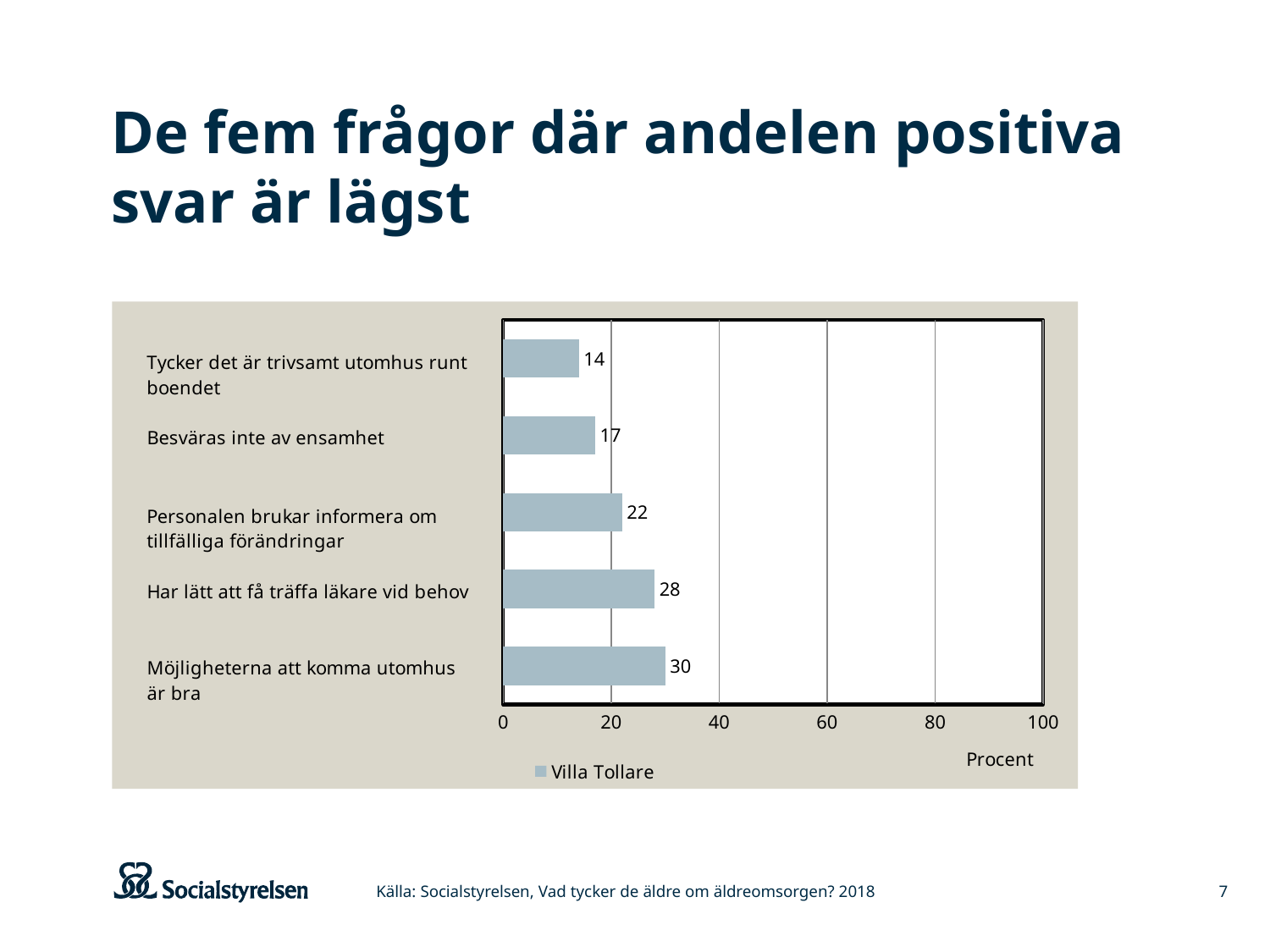
What series name does the legend show? Villa Tollare What is the value for "Möjligheterna att komma utomhus är bra"? 30 Which is larger: the value for "Har lätt att få träffa läkare vid behov" or the value for "Personalen brukar informera om tillfälliga förändringar"? Har lätt att få träffa läkare vid behov What is the value for "Besväras inte av ensamhet"? 17 What is the difference between the values for "Möjligheterna att komma utomhus är bra" and "Tycker det är trivsamt utomhus runt boendet"? 16 How many categories are shown in the chart? 5 What kind of chart is shown on the slide? Bar chart What is the value for "Personalen brukar informera om tillfälliga förändringar"? 22 Which category has the lowest value? Tycker det är trivsamt utomhus runt boendet What is the value for "Tycker det är trivsamt utomhus runt boendet"? 14 Which category has the highest value? Möjligheterna att komma utomhus är bra What is the value for "Har lätt att få träffa läkare vid behov"? 28